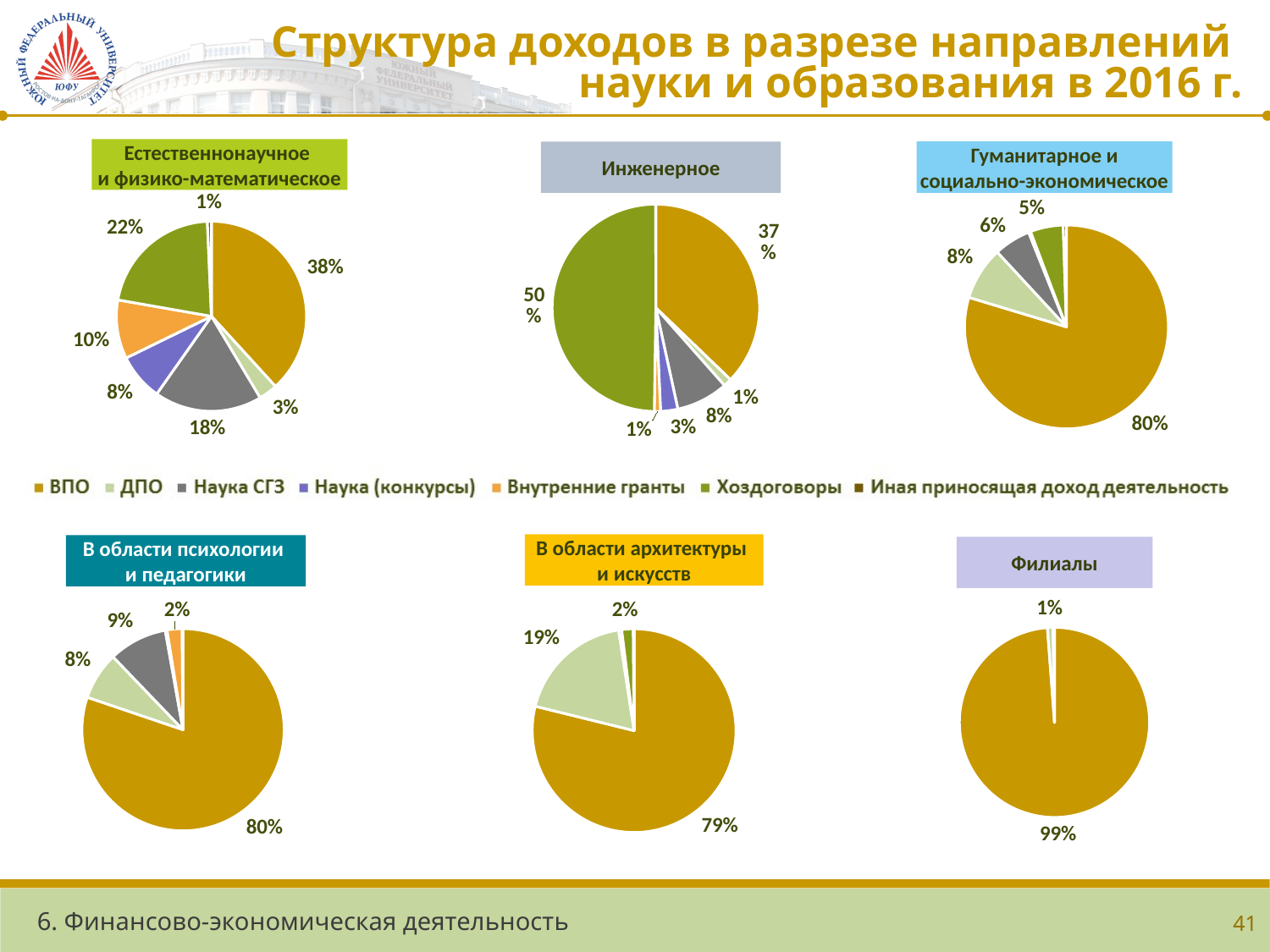
In the 'Инженерное' chart, which is larger: the share of 'ВПО' or the share of 'Хоздоговоры'? Хоздоговоры What kind of charts are shown on the slide? Pie charts How many pie charts are on the slide? 6 How many series does the shared legend list? 7 In the 'Филиалы' chart, what is the share of the largest slice? 99% In the 'Гуманитарное и социально-экономическое' chart, what is the share of 'ВПО'? 80% In the 'В области психологии и педагогики' chart, what is the share of 'Наука СГЗ'? 9% In the 'Естественнонаучное и физико-математическое' chart, what is the difference between the 'Хоздоговоры' share and the 'Наука СГЗ' share? 4% In the 'Инженерное' chart, what share does 'Хоздоговоры' have? 50% In the 'Естественнонаучное и физико-математическое' chart, which category has the largest share? ВПО